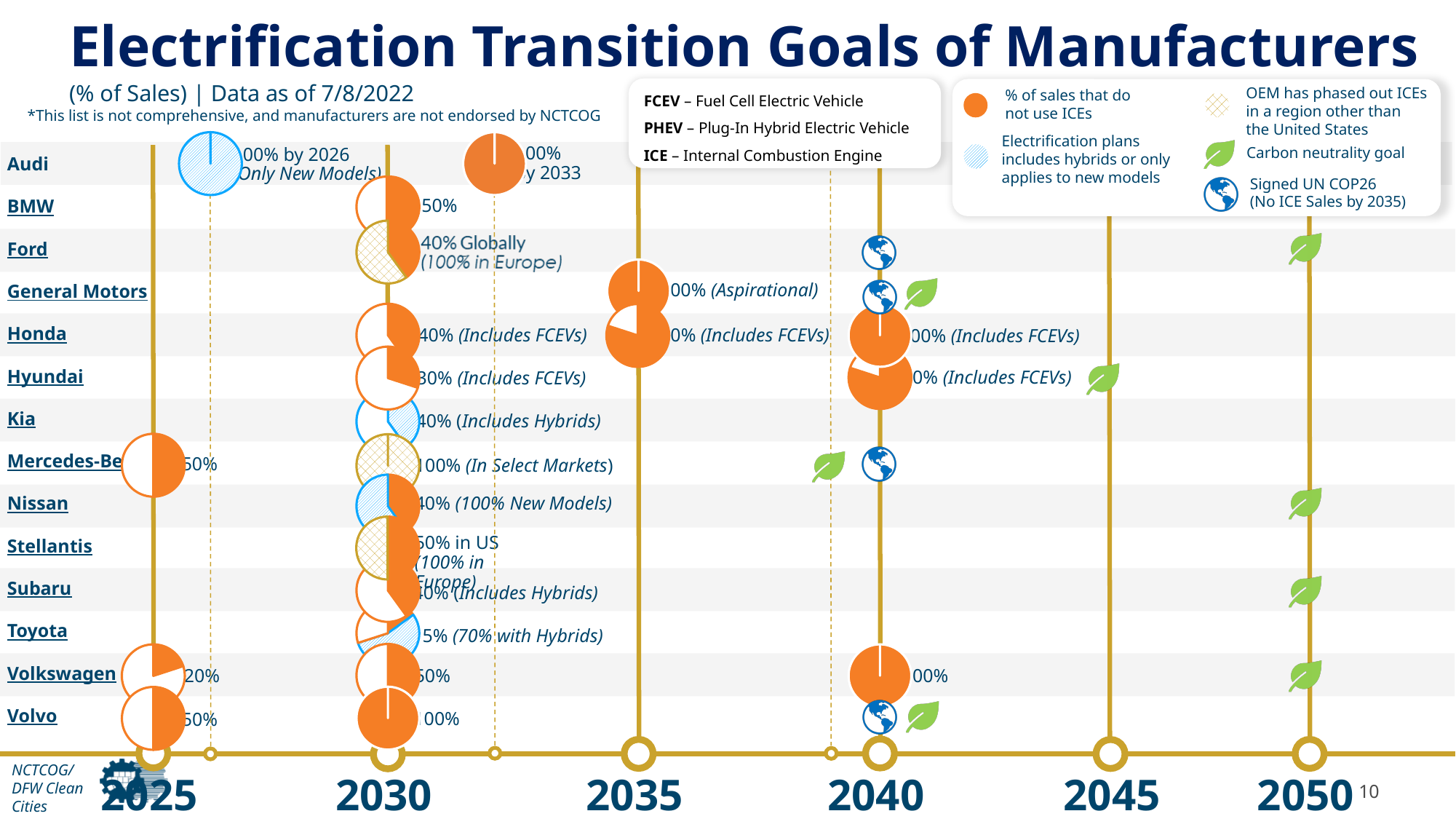
What percentage of sales does Volkswagen target for 2025? 20% Which has the larger 2025 goal, Volkswagen or Volvo? Volvo What is Toyota's 2030 goal when hybrids are included? 70% What is Ford's global goal for 2030? 40% By how many percentage points does Volvo's 2025 goal exceed Volkswagen's 2025 goal? 30 percentage points How many year markers are shown along the timeline axis? 6 What is Hyundai's 2030 goal (including FCEVs)? 30% What percentage of sales does Volvo target for 2025? 50% What is BMW's electrification goal for 2030 shown on the timeline? 50% According to the legend, what does the green leaf icon represent? Carbon neutrality goal How many manufacturers are listed on the timeline? 14 In which year does Volkswagen target 100% of sales not using ICEs? 2040